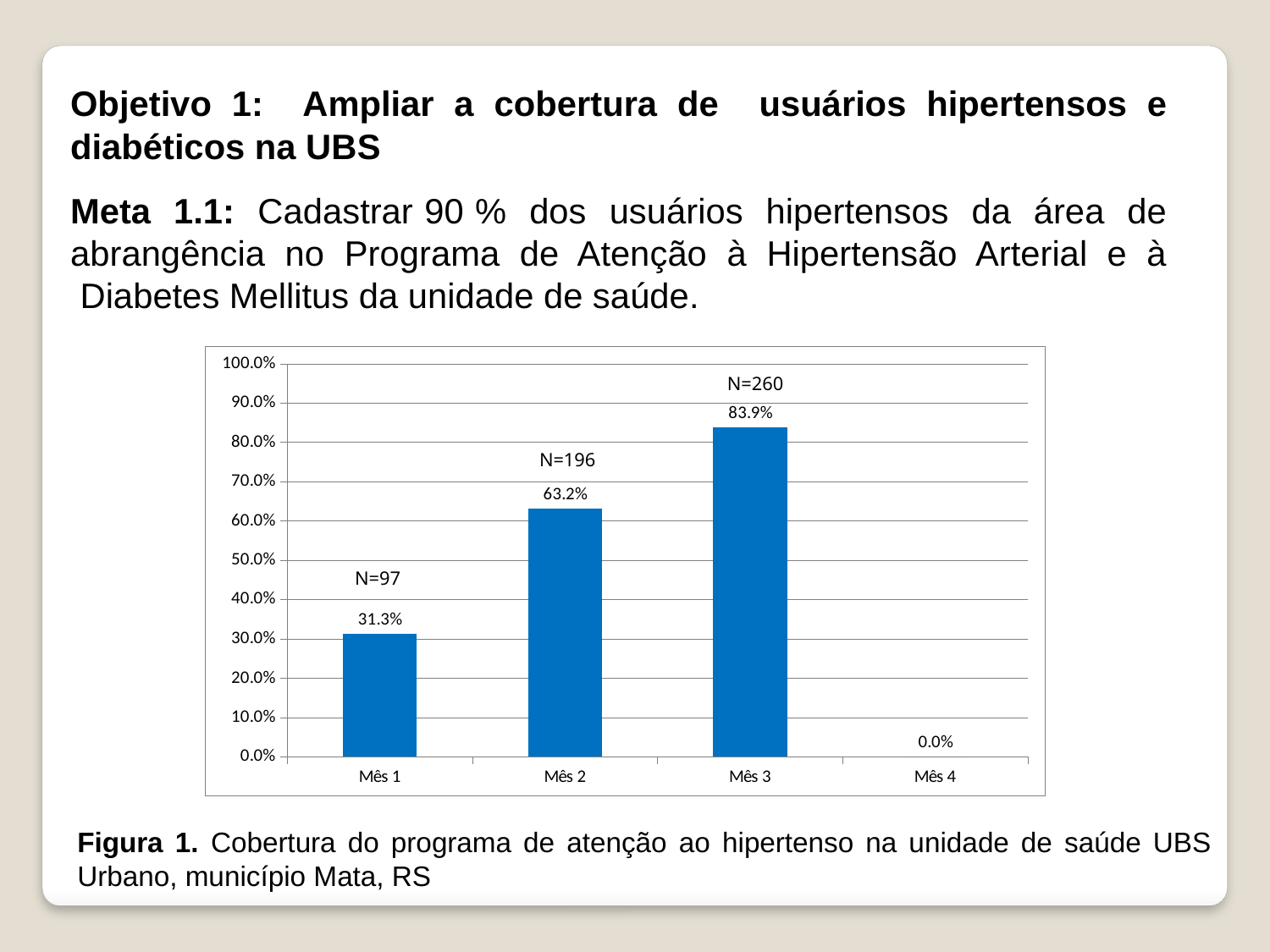
What kind of chart is shown on the slide? Bar chart What is the value for Mês 3? 83.9% What is the value for Mês 1? 31.3% Which month has the lowest value? Mês 4 Which month has the highest value? Mês 3 What is the value for Mês 4? 0.0% What is the value for Mês 2? 63.2% What is the N value shown above the bar for Mês 2? N=196 Do the values rise or fall from Mês 1 to Mês 3? Rise What is the difference between the values for Mês 3 and Mês 2? 20.7% How many months are shown on the x axis? 4 Which is larger, the value for Mês 1 or the value for Mês 2? Mês 2